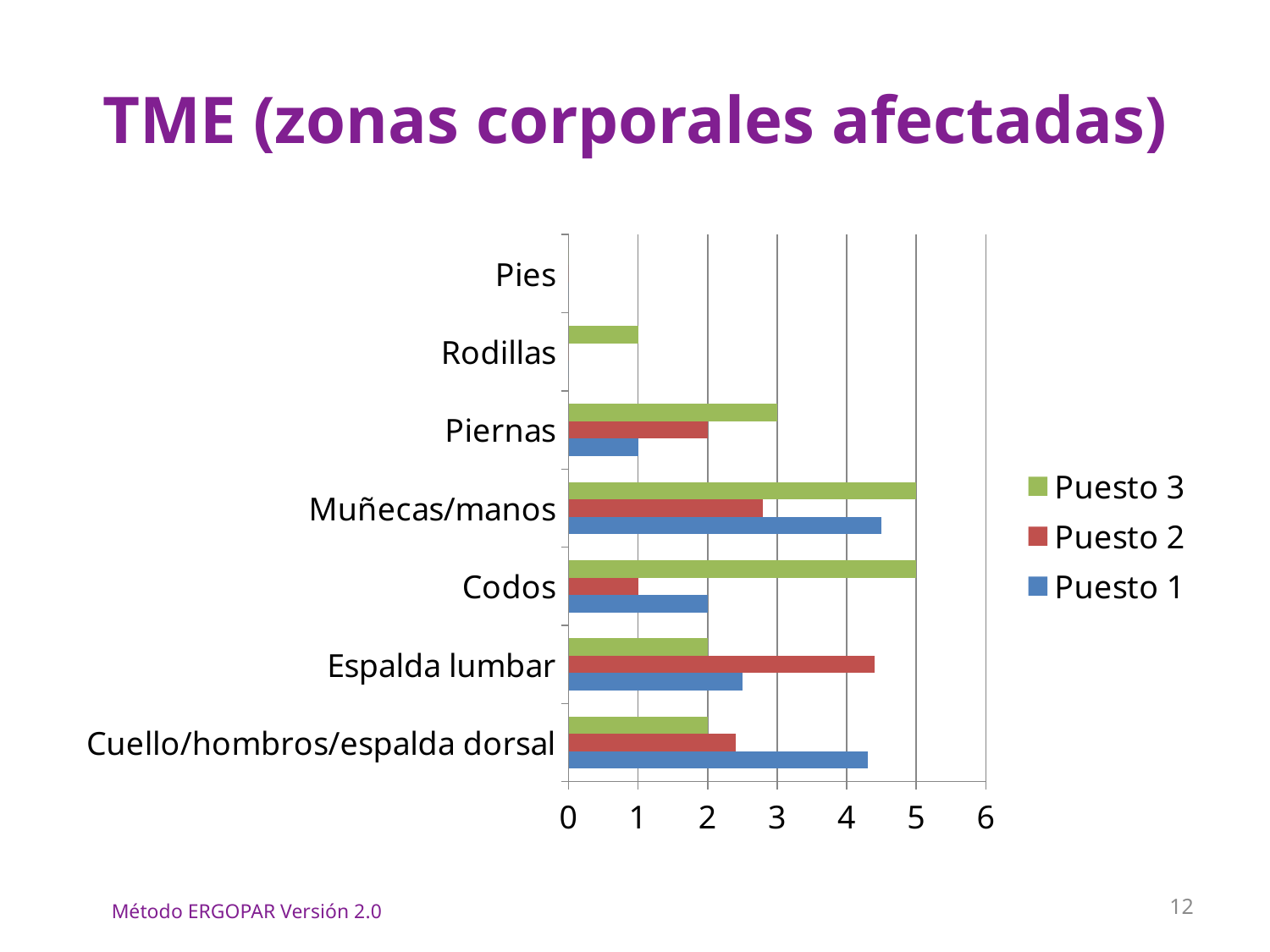
How many series does the legend list? 3 What is the value for Puesto 3 in the Codos category? 5 How many body-zone categories are shown on the chart? 7 In the Espalda lumbar category, which is larger: Puesto 2 or Puesto 1? Puesto 2 What kind of chart is shown on the slide? Bar chart What is the value for Puesto 3 in the Rodillas category? 1 Is the value for Puesto 2 in the Muñecas/manos category greater or less than 3? less Is the value for Puesto 1 in the Muñecas/manos category greater or less than 4? greater What is the value for Puesto 1 in the Piernas category? 1 What is the difference between Puesto 3 and Puesto 2 in the Codos category? 4 What is the difference between Puesto 3 and Puesto 1 in the Piernas category? 2 Which category has the highest value for Puesto 2? Espalda lumbar